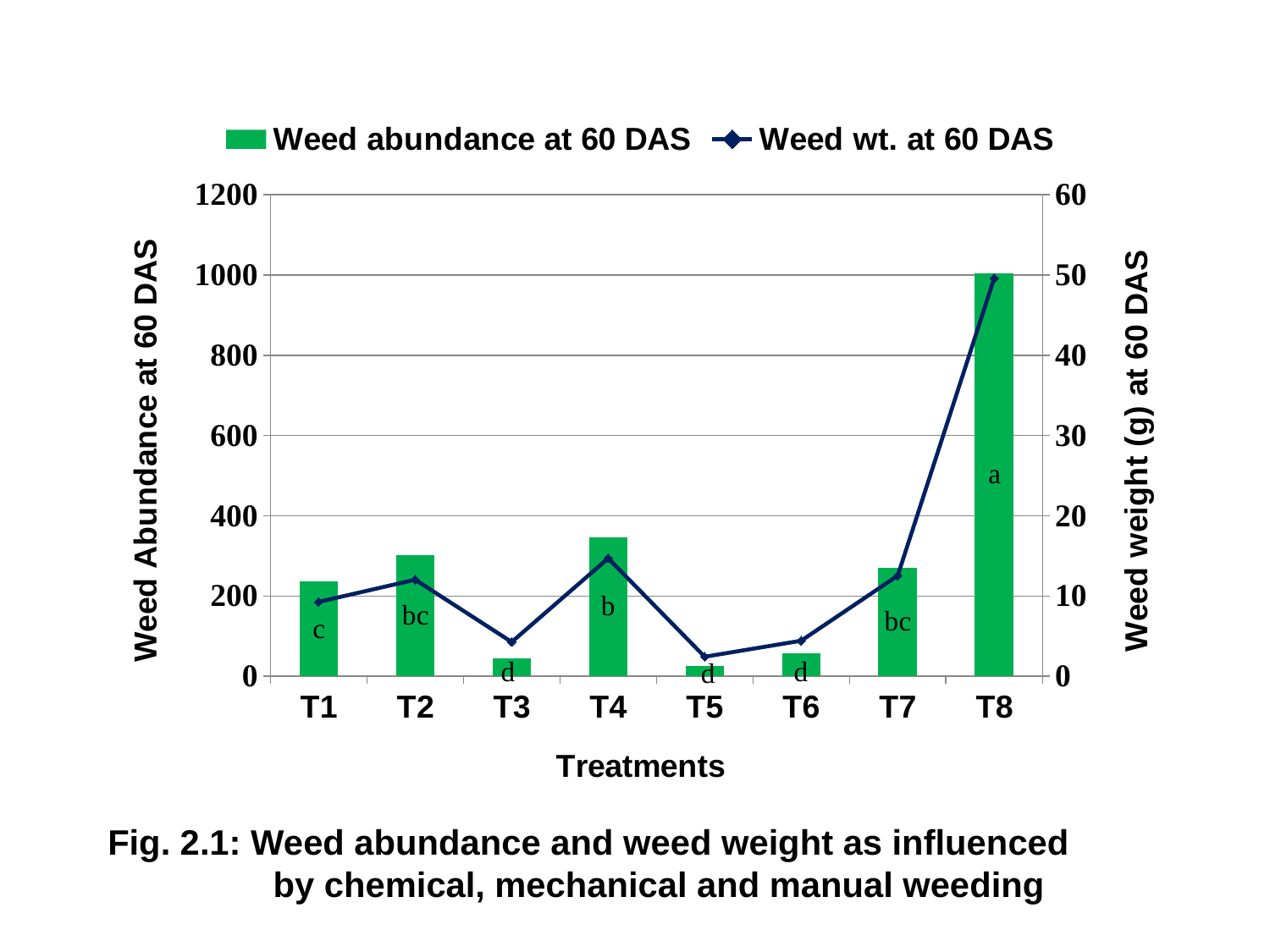
How many series does the legend list? 2 Which has the higher weed abundance at 60 DAS, T2 or T4? T4 Which treatment has the lowest weed abundance at 60 DAS? T5 Which treatment has the highest weed weight at 60 DAS? T8 Is the weed abundance at 60 DAS for T8 greater or less than 800? greater Is the weed abundance at 60 DAS for T4 greater or less than 400? less What letter label is printed on the T8 bar? a Is the weed weight at 60 DAS for T8 greater or less than 40? greater Which treatment has the highest weed abundance at 60 DAS? T8 How many treatments are shown on the x axis? 8